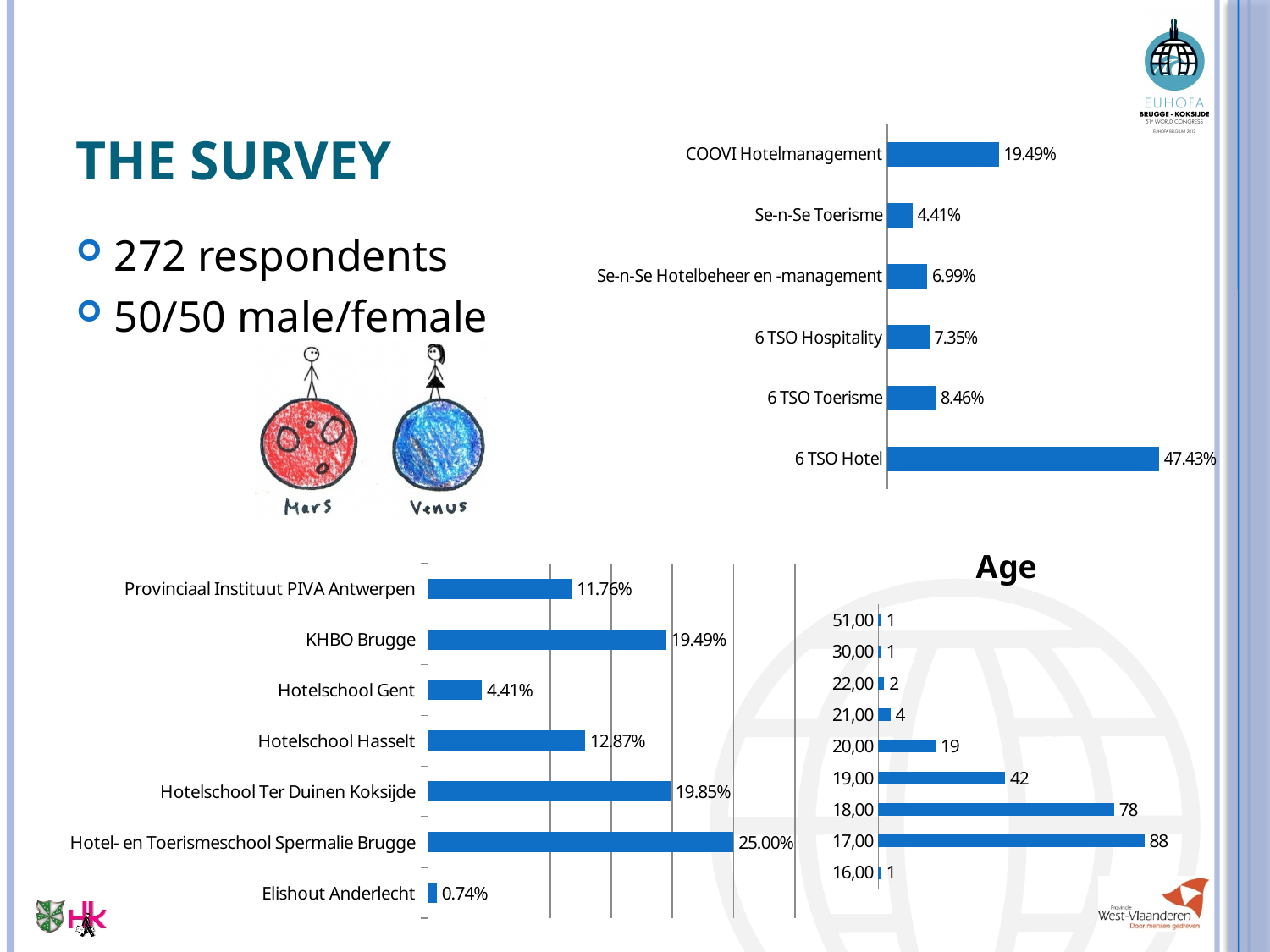
In the bottom-left chart, which school has the highest value? Hotel- en Toerismeschool Spermalie Brugge In the top-right chart, what is the difference between COOVI Hotelmanagement and 6 TSO Toerisme? 11.03% In the Age chart, what is the value for 18,00? 78 What type of chart is the Age chart? Bar chart In the bottom-left chart, what is the value for Hotelschool Hasselt? 12.87% In the top-right chart, what is the value for 6 TSO Hotel? 47.43% In the bottom-left chart, which is larger: Hotelschool Ter Duinen Koksijde or KHBO Brugge? Hotelschool Ter Duinen Koksijde In the Age chart, which age has the highest value? 17,00 In the bottom-left chart, which school has the lowest value? Elishout Anderlecht In the Age chart, what is the difference between the values for 19,00 and 20,00? 23 In the top-right chart, how many categories are shown? 6 In the top-right chart, which category has the lowest value? Se-n-Se Toerisme